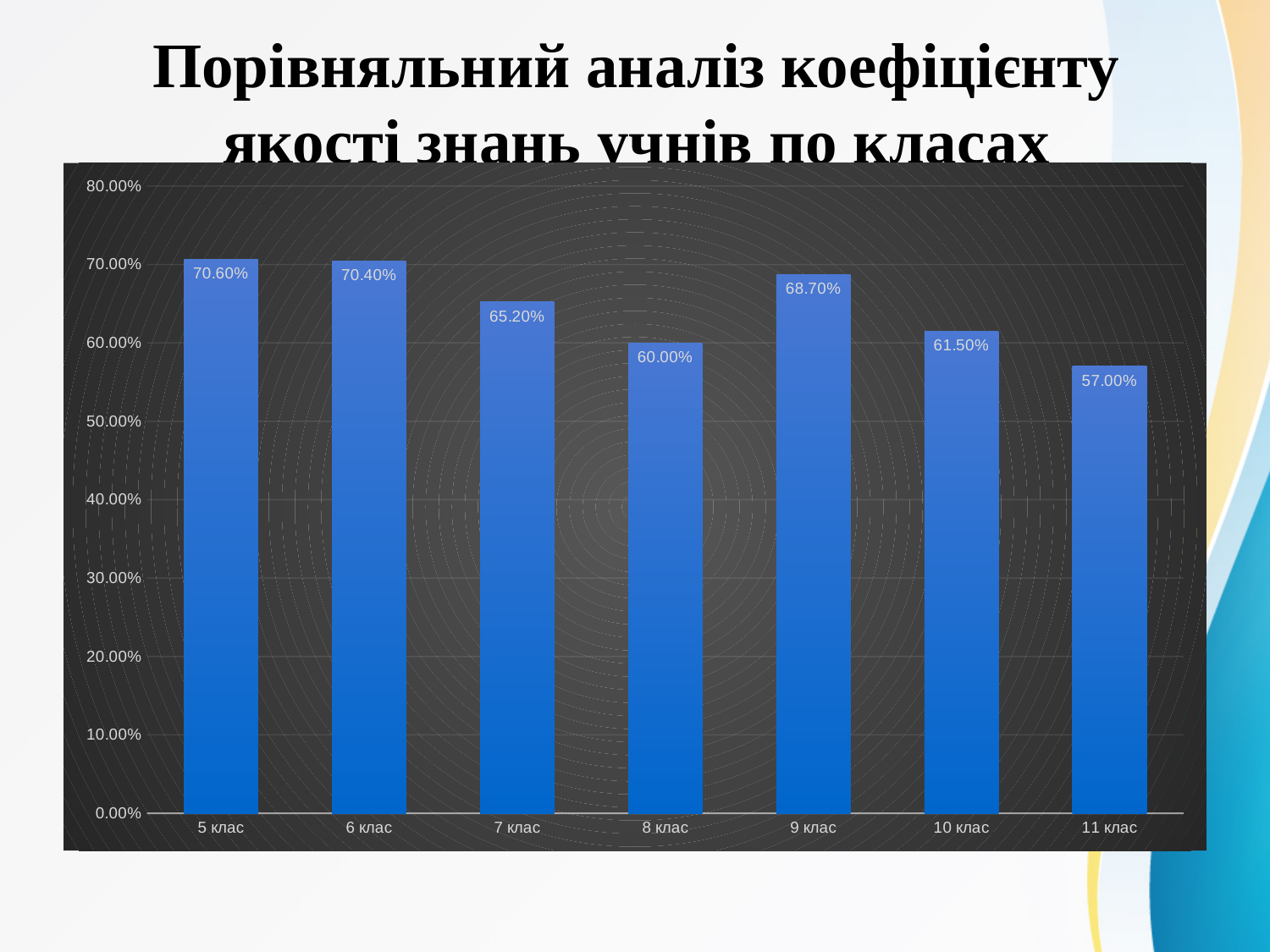
What is the value for 9 клас? 68.70% What kind of chart is shown on the slide? bar chart Which is larger, the value for 7 клас or the value for 10 клас? 7 клас What is the title of the chart on the slide? Порівняльний аналіз коефіцієнту якості знань учнів по класах Which class has the lowest value? 11 клас How many classes are shown on the chart? 7 Is the value for 8 клас greater or less than 70.00%? less What is the difference between the values for 9 клас and 8 клас? 8.70% What is the difference between the values for 5 клас and 11 клас? 13.60% What is the value for 5 клас? 70.60% Which class has the highest value? 5 клас What is the value for 11 клас? 57.00%